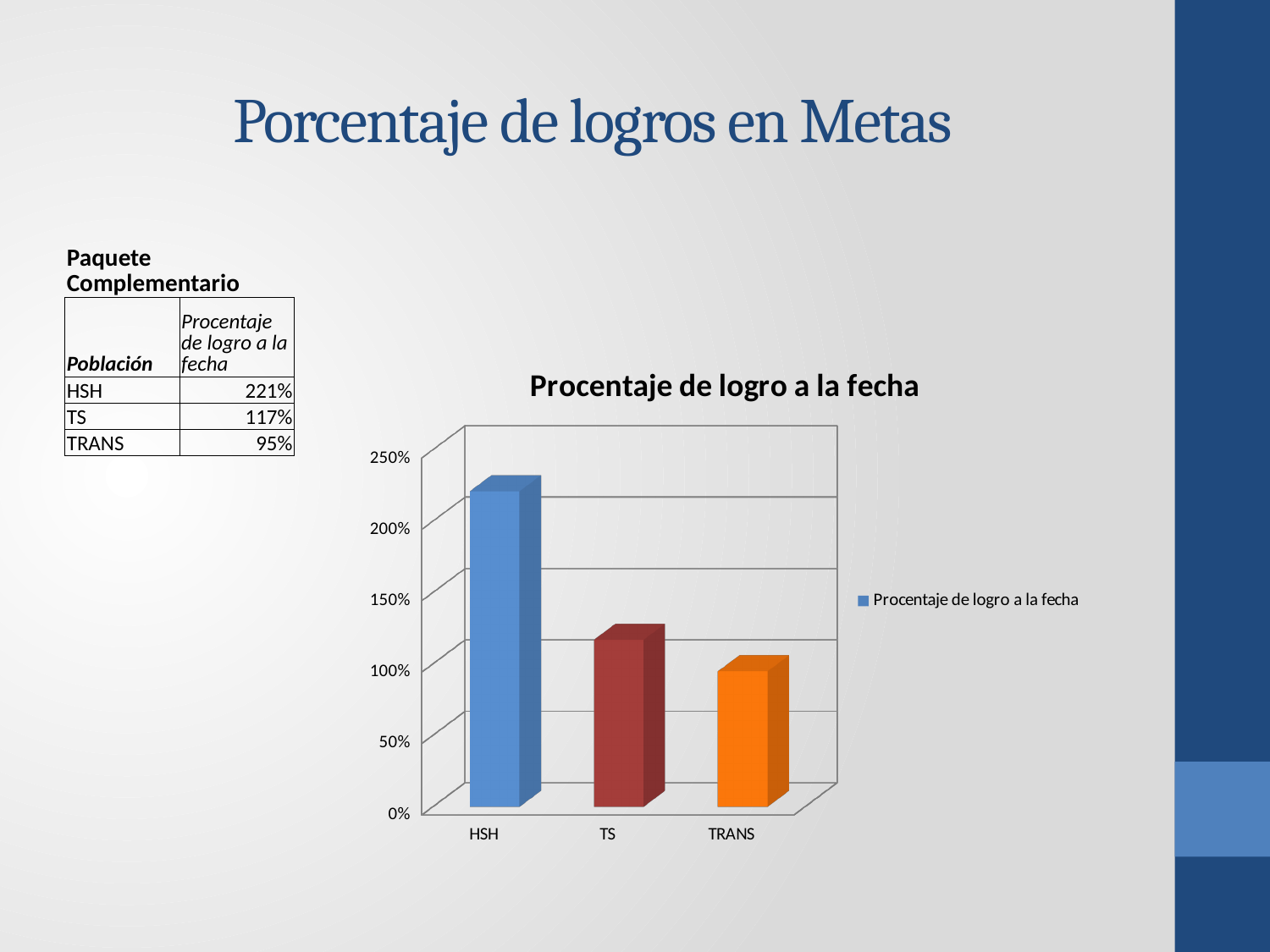
How many categories are shown on the x axis of the chart? 3 How many series does the chart legend list? 1 What is the difference between the values for HSH and TS? 104% Which category has the highest value in the chart? HSH Do the values rise or fall from HSH to TRANS along the x axis? fall What is the value for TRANS? 95% What is the value for TS? 117% What kind of chart is shown on the slide? bar chart Which category has the lowest value in the chart? TRANS What is the title of the chart? Procentaje de logro a la fecha What is the value for HSH? 221% Is the value for TRANS greater or less than 100%? less